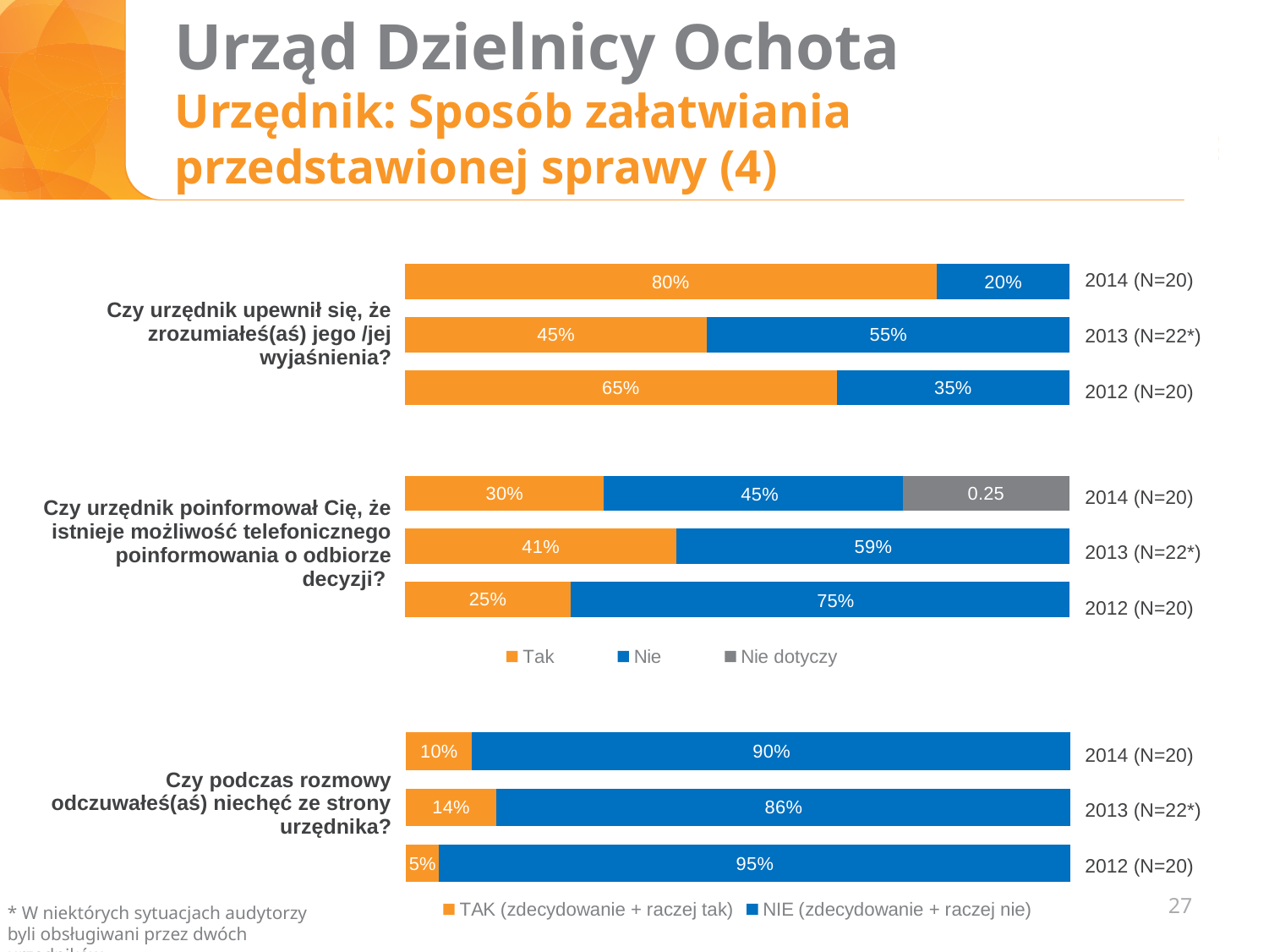
In the top chart, which year has the highest "Tak" share? 2014 (N=20) In the top chart, what is the difference between the "Tak" values for 2014 and 2012? 15% In the bottom chart, is the "TAK" value for 2014 larger or smaller than the "TAK" value for 2013? smaller In the top chart, what is the "Nie" value for 2013 (N=22*)? 55% In the middle chart ("Czy urzędnik poinformował Cię, że istnieje możliwość telefonicznego poinformowania o odbiorze decyzji?"), what is the "Nie" value for 2012 (N=20)? 75% In the middle chart, which year has the lowest "Tak" share? 2012 (N=20) How many series does the legend of the middle chart list? 3 In the middle chart, what value is shown for "Nie dotyczy" in 2014 (N=20)? 0.25 What type of chart is used on this slide? Stacked bar chart In the top chart ("Czy urzędnik upewnił się, że zrozumiałeś(aś) jego /jej wyjaśnienia?"), what is the "Tak" value for 2014 (N=20)? 80% In the bottom chart, which year has the highest "TAK" share? 2013 (N=22*) In the bottom chart ("Czy podczas rozmowy odczuwałeś(aś) niechęć ze strony urzędnika?"), what is the "NIE" value for 2012 (N=20)? 95%